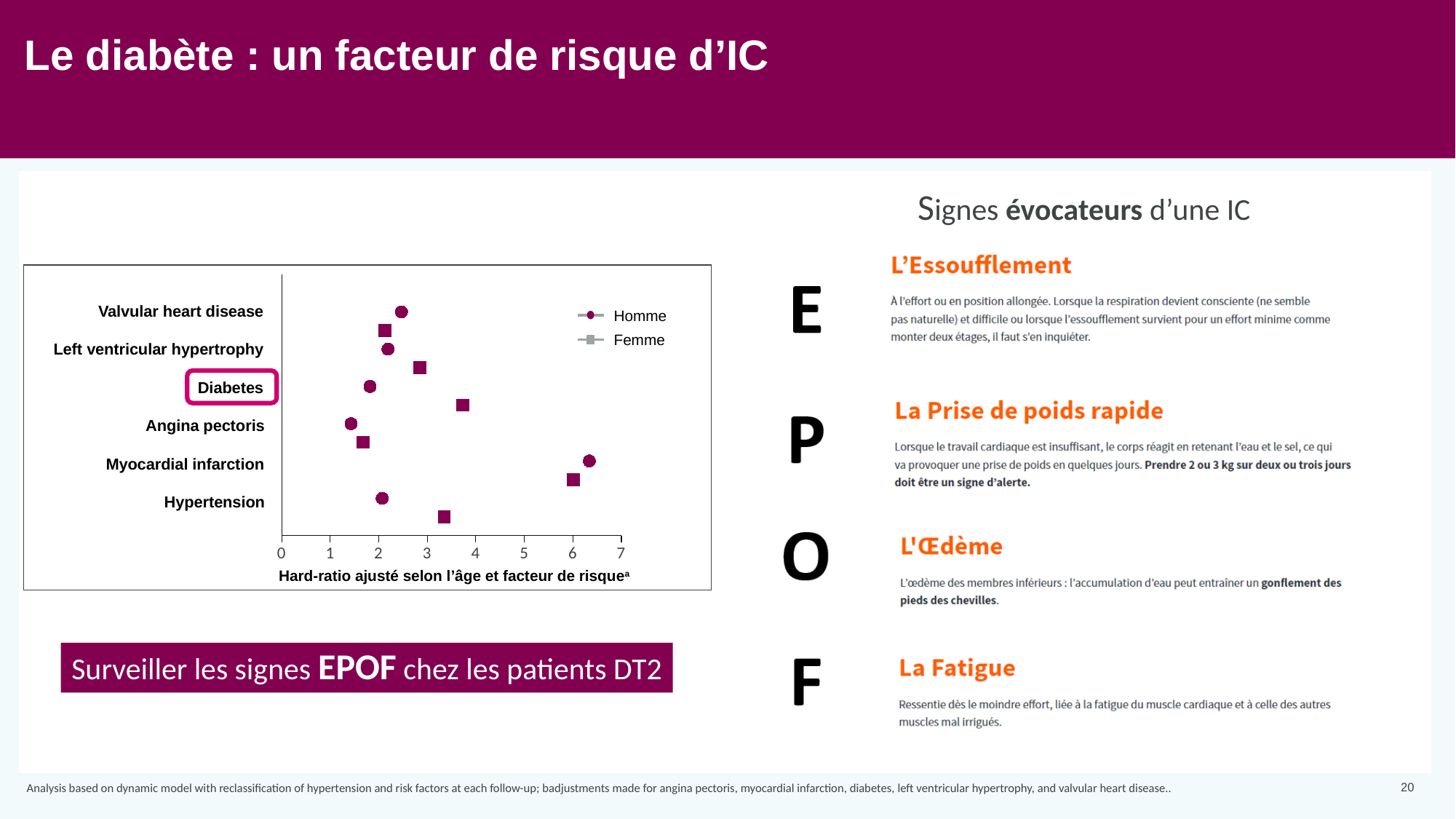
For the Homme series, which category has the lowest hazard ratio? Angina pectoris Is the Femme value for Diabetes greater or less than 3? greater For Diabetes, which series has the larger value, Homme or Femme? Femme For the Homme series, which category has the highest hazard ratio? Myocardial infarction For Hypertension, which series has the larger value, Homme or Femme? Femme Is the Homme value for Myocardial infarction greater or less than 6? greater What kind of chart is shown on the slide? scatter chart What is the label of the chart's x axis? Hard-ratio ajusté selon l'âge et facteur de risque How many series does the chart's legend list? 2 Is the Homme value for Diabetes greater or less than 3? less How many risk-factor categories are plotted on the chart? 6 For the Femme series, which category has the highest hazard ratio? Myocardial infarction